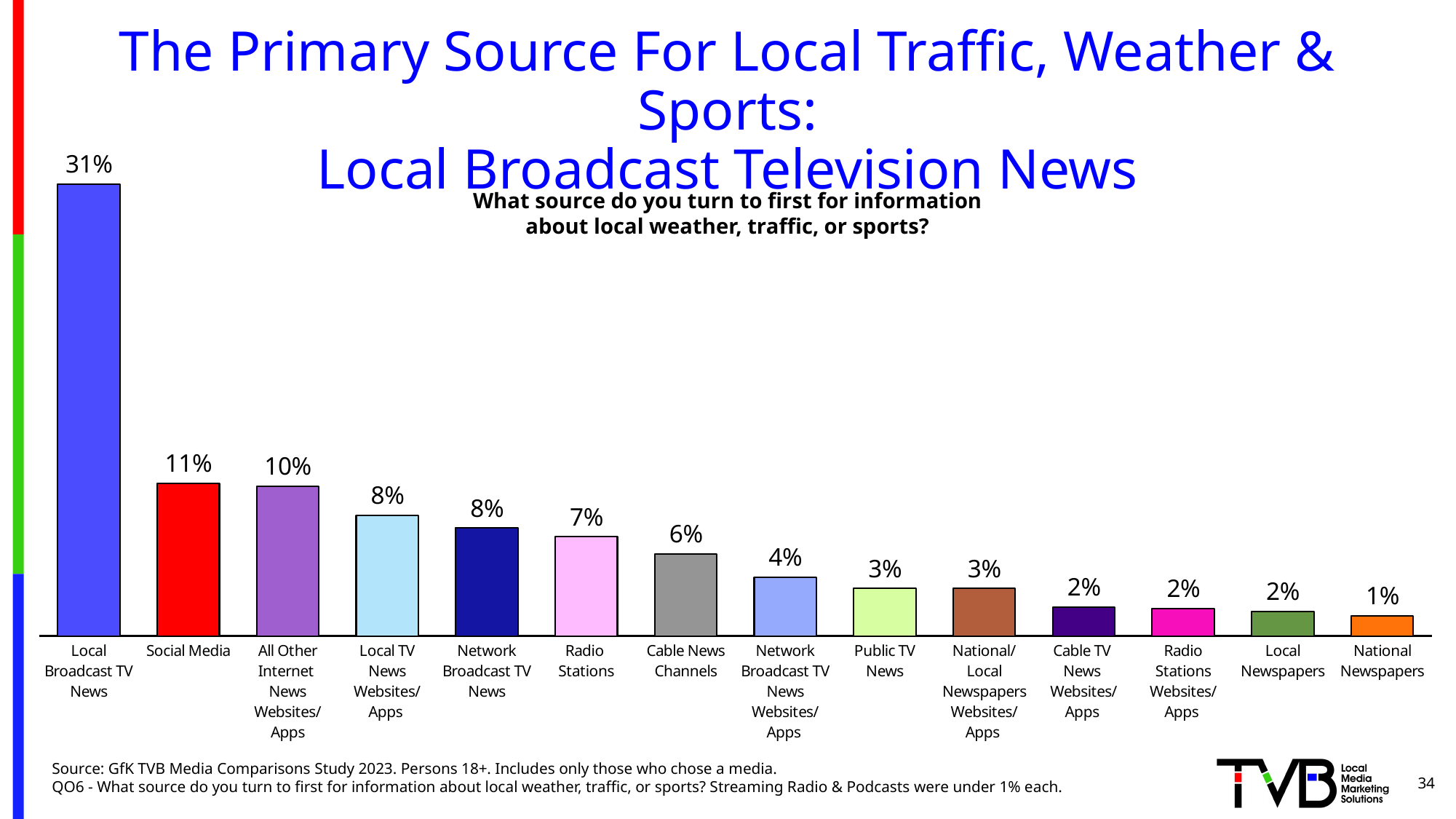
Which source has the highest percentage in the chart? Local Broadcast TV News What is the value for National Newspapers? 1% What is the value shown for Social Media? 11% What type of chart is shown on the slide? Bar chart How many sources (bars) are shown in the chart? 14 Which is larger, the value for Radio Stations or the value for Public TV News? Radio Stations Do the values rise or fall moving from left to right across the chart? Fall What is the difference in percentage points between Local Broadcast TV News and Social Media? 20 What percentage of respondents turn first to Local Broadcast TV News for local weather, traffic, or sports? 31% Which source has the lowest percentage in the chart? National Newspapers What question is the chart based on, as shown in the subtitle above the bars? What source do you turn to first for information about local weather, traffic, or sports? What percentage is shown for Cable News Channels? 6%